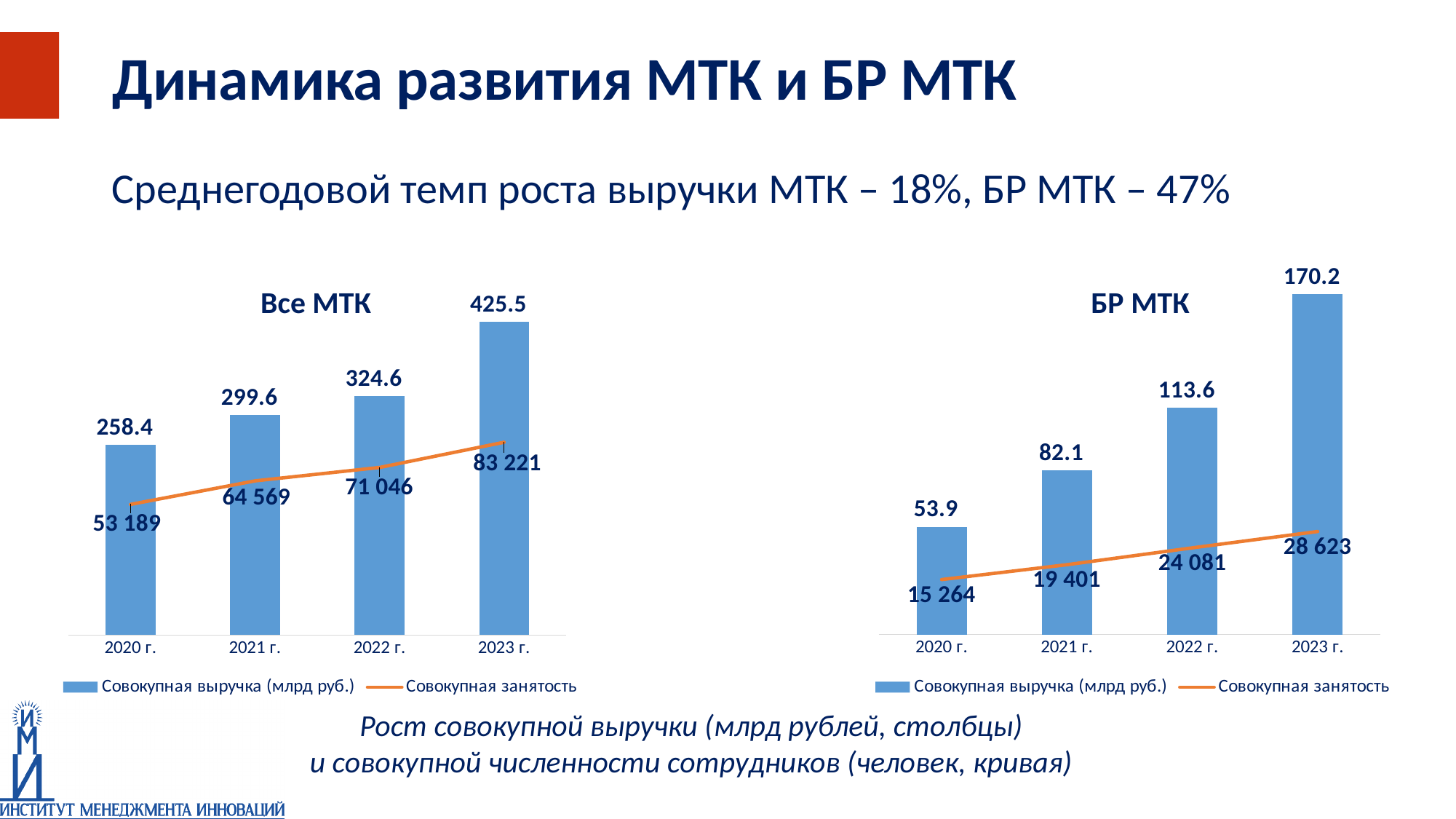
In the 'БР МТК' chart, which year has the highest total revenue? 2023 г. In the 'БР МТК' chart, what is the difference in total revenue between 2021 г. and 2020 г.? 28.2 In the 'Все МТК' chart, what is the difference in total revenue between 2023 г. and 2022 г.? 100.9 What kind of chart is the 'БР МТК' chart? Combined bar and line chart Which is larger: the 2022 г. revenue in the 'Все МТК' chart or the 2023 г. revenue in the 'БР МТК' chart? 2022 г. revenue in 'Все МТК' (324.6) In the 'Все МТК' chart, what is the total revenue (Совокупная выручка) for 2023 г.? 425.5 In the 'Все МТК' chart, does total employment rise or fall from 2020 г. to 2023 г.? Rises In the 'Все МТК' chart, which year has the lowest total revenue? 2020 г. In the 'БР МТК' chart, what is the total employment (Совокупная занятость) value for 2021 г.? 19 401 How many series does the legend of the 'Все МТК' chart list? 2 How many years are shown on the x axis of the 'БР МТК' chart? 4 In the 'БР МТК' chart, what is the total employment value for 2023 г.? 28 623